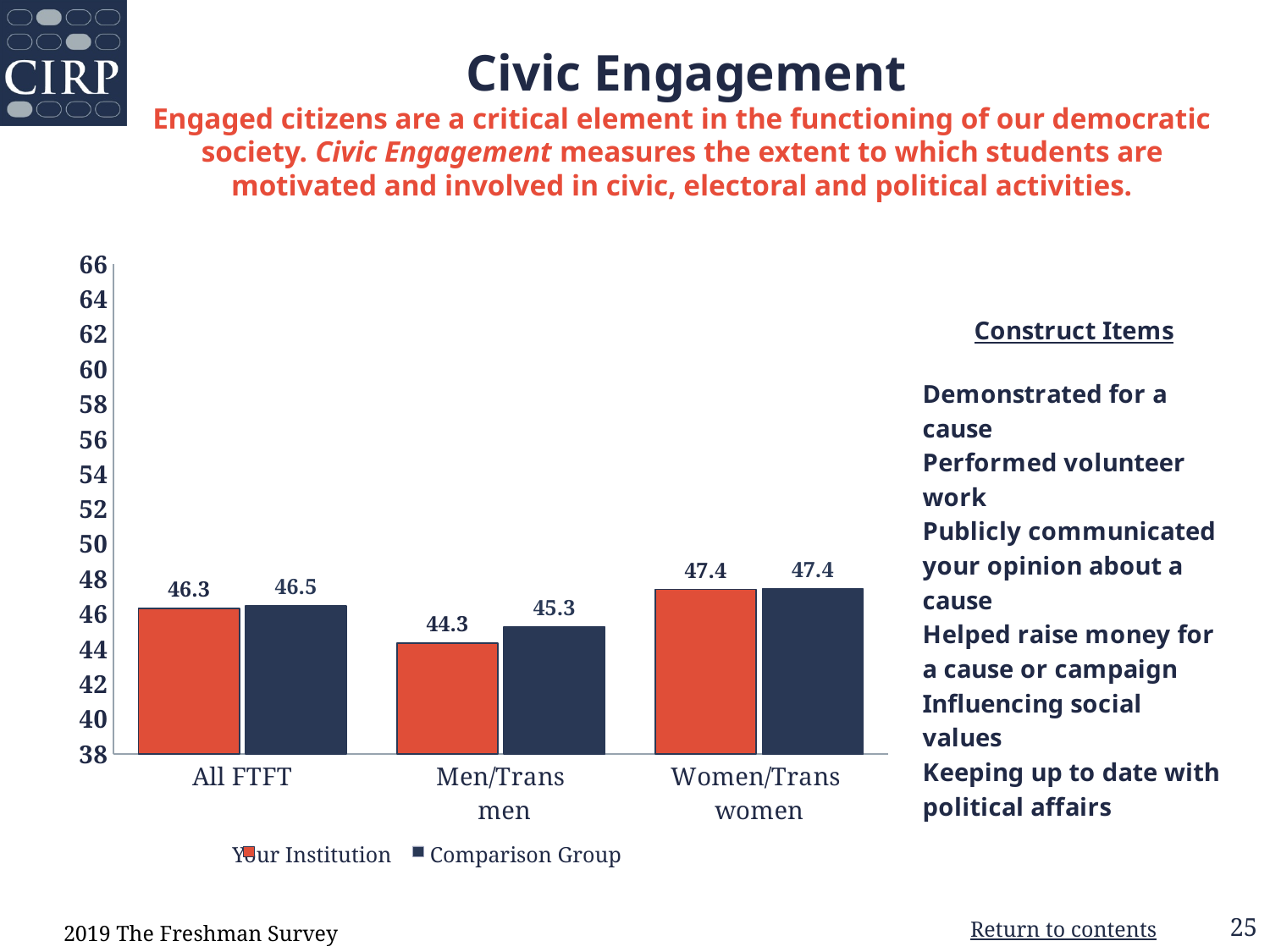
What is the Your Institution value for Women/Trans women? 47.4 Which category has the lowest Comparison Group value? Men/Trans men What kind of chart is shown on the slide? bar chart What is the Comparison Group value for Men/Trans men? 45.3 What is the difference between the Comparison Group and Your Institution values for Men/Trans men? 1.0 What colour are the Your Institution bars? orange-red What is the Your Institution value for All FTFT? 46.3 Which category has the highest Your Institution value? Women/Trans women Is the Your Institution value for Men/Trans men greater or less than 46? less How many series does the legend list? 2 How many categories are shown on the x axis? 3 For Men/Trans men, which is larger: Your Institution or Comparison Group? Comparison Group